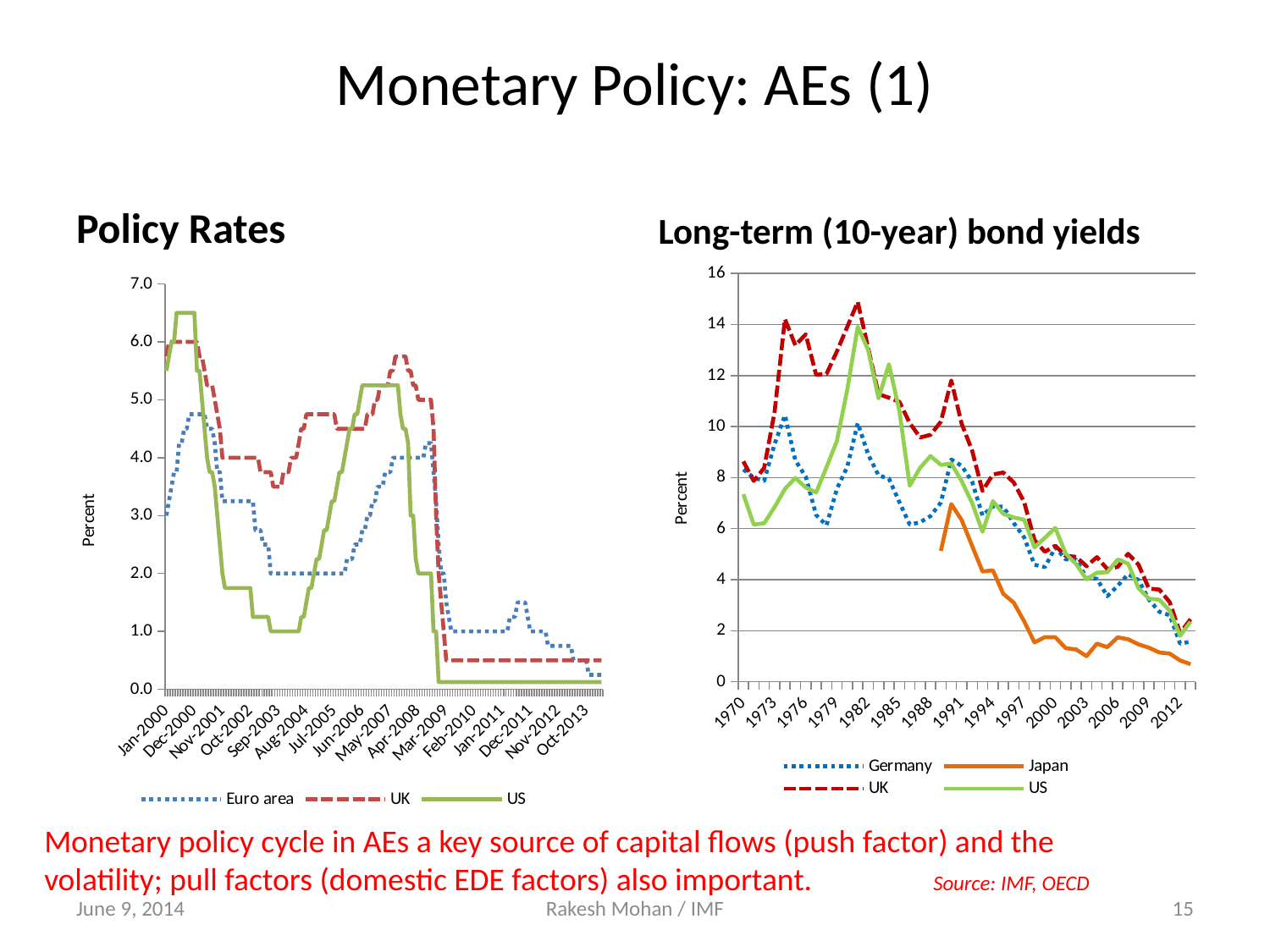
In the Policy Rates chart, which series has the lowest value from 2009 onwards? US How many series does the legend of the Policy Rates chart list? 3 In the Long-term (10-year) bond yields chart, is the peak value for UK around 1982 greater or less than 14? greater What kind of chart is the Policy Rates chart? line chart In the Policy Rates chart, which series reaches the highest value around 2000? US How many series does the legend of the Long-term (10-year) bond yields chart list? 4 In the Policy Rates chart, is the value for Euro area in Oct-2013 greater or less than 1.0? less In the Long-term (10-year) bond yields chart, is the value for Japan in 2012 greater or less than 2? less In the Long-term (10-year) bond yields chart, do the yields generally rise or fall from 1982 to 2012? fall In the Long-term (10-year) bond yields chart, which series is larger in 1976, UK or Germany? UK In the Long-term (10-year) bond yields chart, which series has the lowest values after 2000? Japan